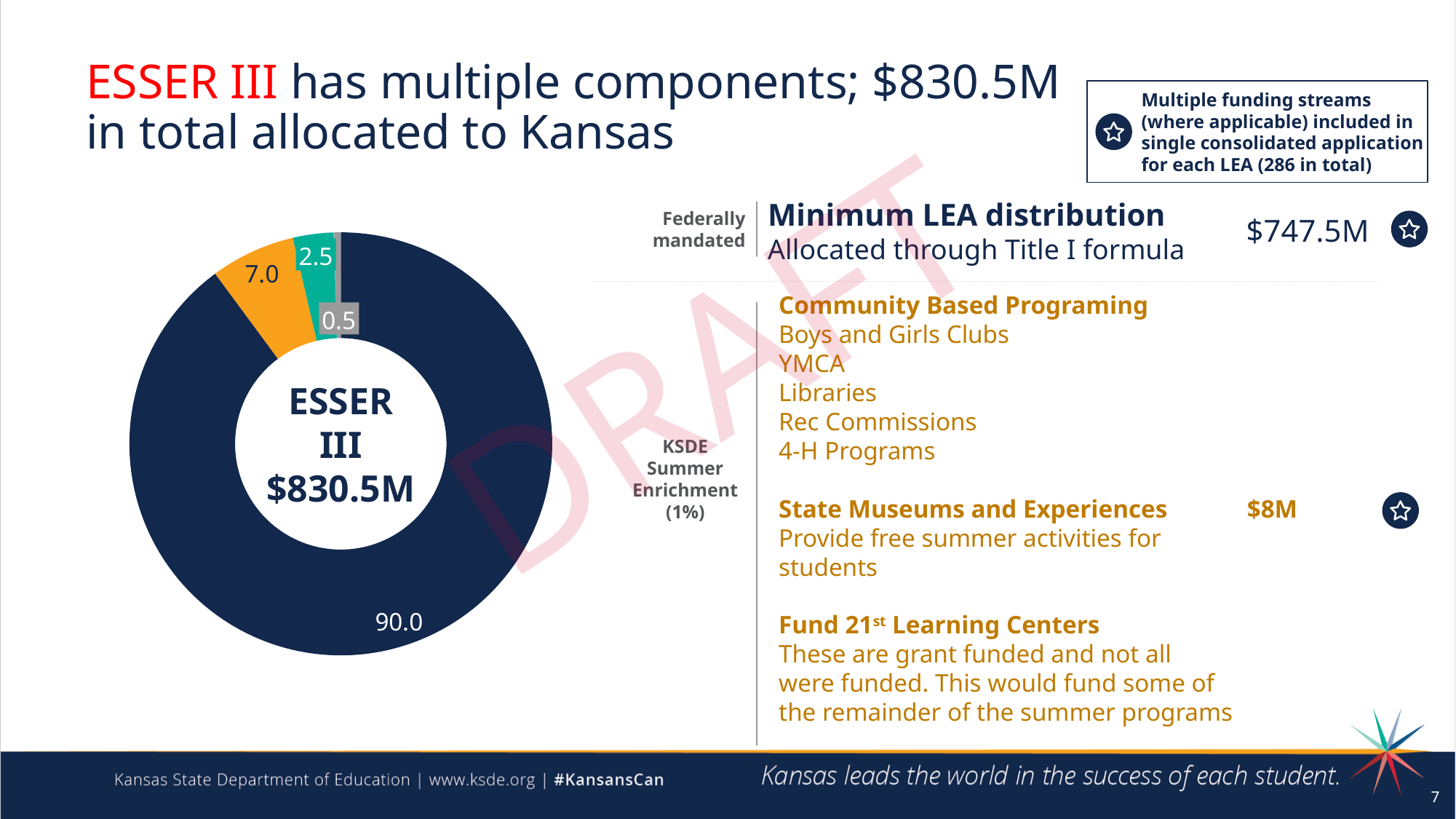
Which is larger in the donut chart: the orange slice or the teal slice? The orange slice What value is labelled on the teal/green slice of the donut chart? 2.5 What is the total of the four slice values labelled on the donut chart? 100.0 What text appears in the centre of the donut chart? ESSER III $830.5M What value is labelled on the orange slice of the donut chart? 7.0 Which slice of the donut chart has the largest value? The dark navy slice (90.0) What is the difference between the orange slice value and the teal slice value in the donut chart? 4.5 What value is labelled on the largest (dark navy) slice of the donut chart? 90.0 What value is labelled on the gray slice of the donut chart? 0.5 Which slice of the donut chart has the smallest value? The gray slice (0.5) What type of chart is shown on the slide? Donut (pie) chart